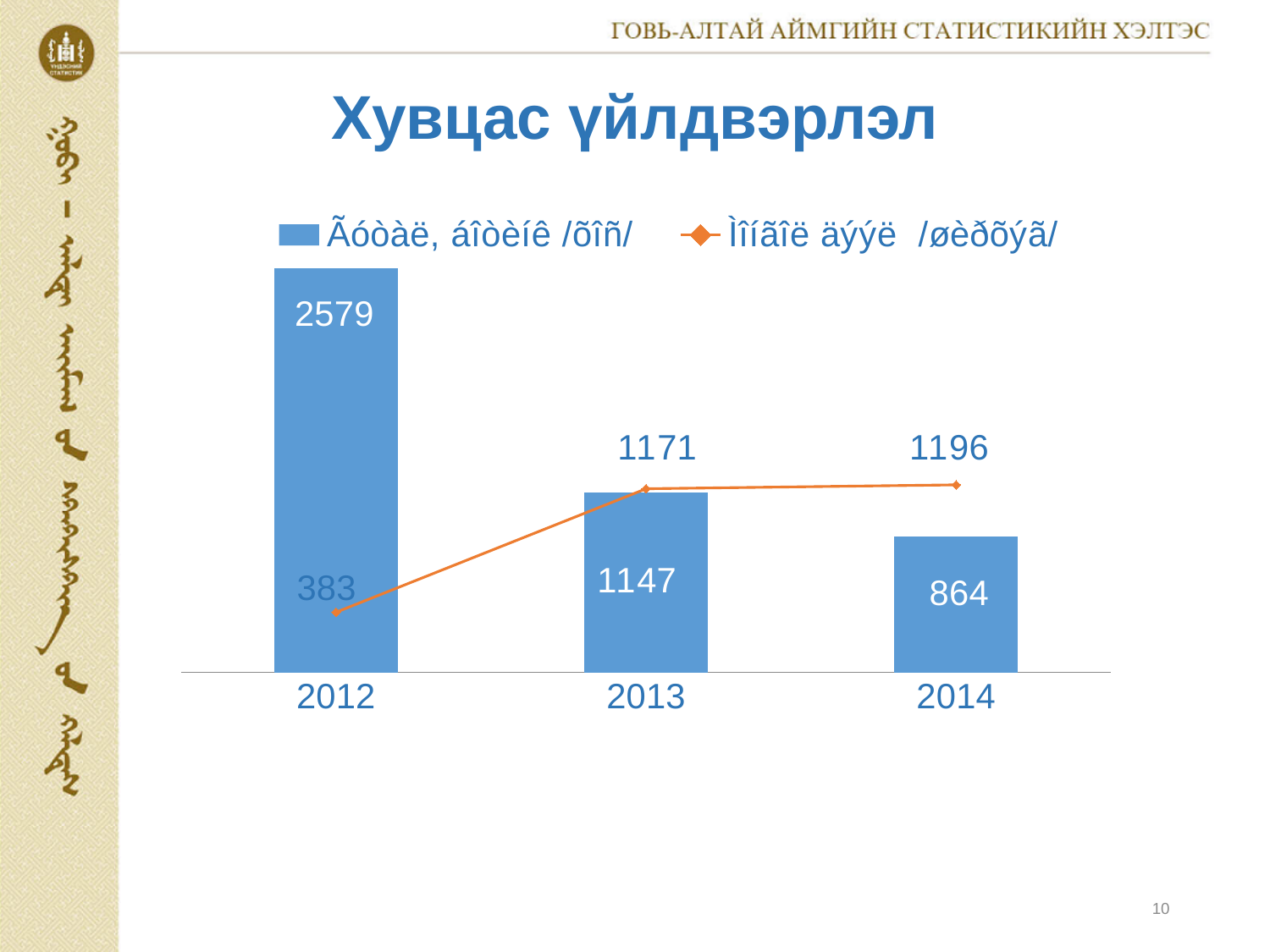
What is the value of the orange line series for 2012? 383 What is the value of the orange line series for 2013? 1171 How many series does the legend list? 2 Which year has the lowest value for the orange line series? 2012 What is the value of the blue bar for 2012? 2579 How many years are shown on the x axis? 3 Which year has the highest value for the blue bar series? 2012 What is the difference between the orange line values for 2014 and 2013? 25 What is the value of the blue bar for 2014? 864 Which is larger in 2014: the blue bar value or the orange line value? the orange line value Do the blue bar values rise or fall from 2012 to 2014? fall What is the difference between the blue bar values for 2012 and 2013? 1432